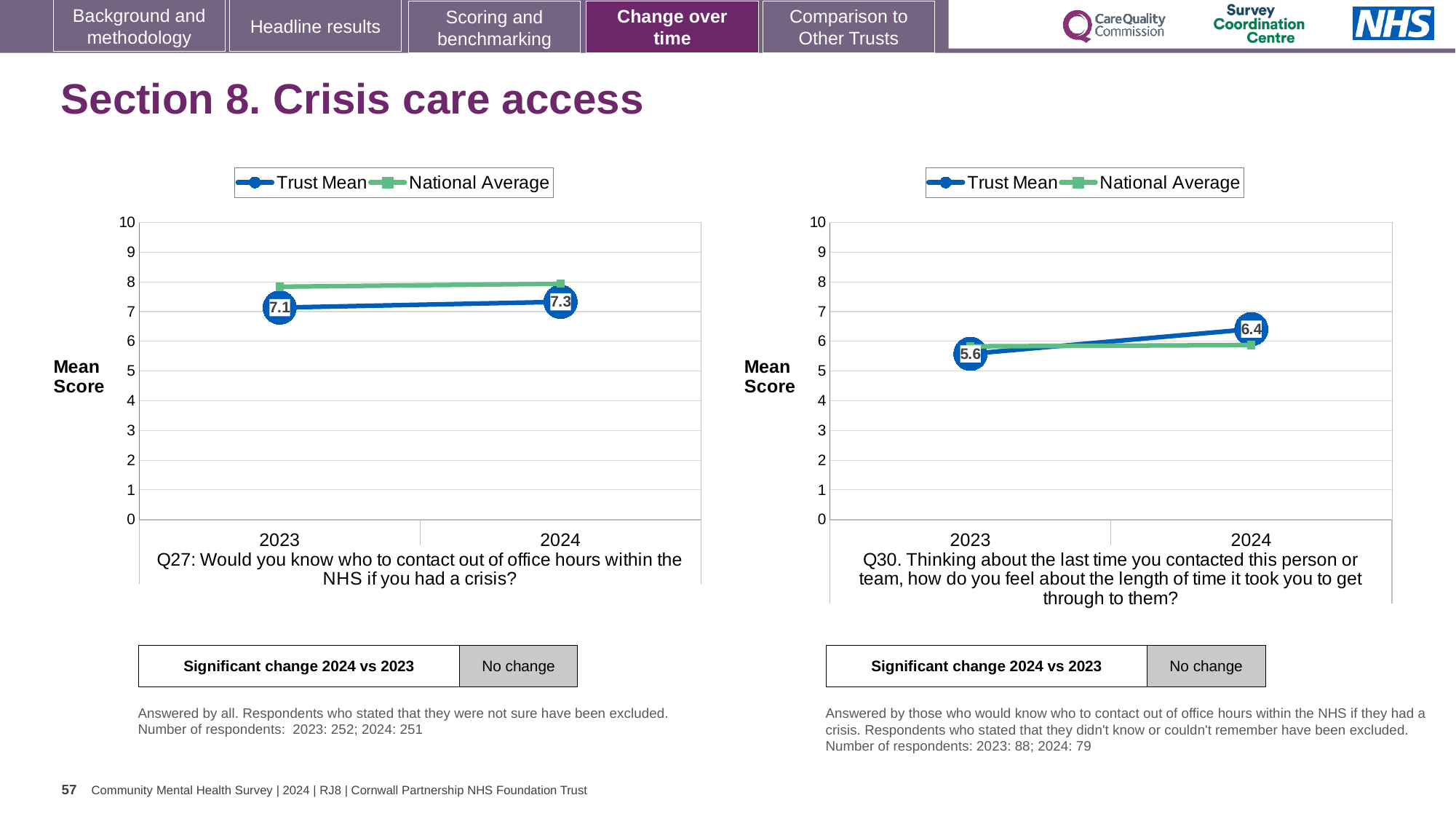
In the Q27 chart on the left, is the National Average for 2023 greater or less than 7? greater In the Q30 chart on the right, what is the Trust Mean score for 2024? 6.4 In the Q30 chart on the right, by how much did the Trust Mean change from 2023 to 2024? 0.8 In the Q27 chart on the left, by how much did the Trust Mean change from 2023 to 2024? 0.2 How many series does the legend of the Q30 chart on the right list? 2 In the Q27 chart on the left, what is the Trust Mean score for 2023? 7.1 In the Q27 chart on the left, what is the Trust Mean score for 2024? 7.3 In the Q30 chart on the right, what is the Trust Mean score for 2023? 5.6 In the Q30 chart on the right, which is higher in 2024, the Trust Mean or the National Average? Trust Mean In the Q30 chart on the right, does the Trust Mean rise or fall from 2023 to 2024? rise What type of chart is the Q27 chart on the left? line chart How many years are shown on the x axis of the Q27 chart on the left? 2